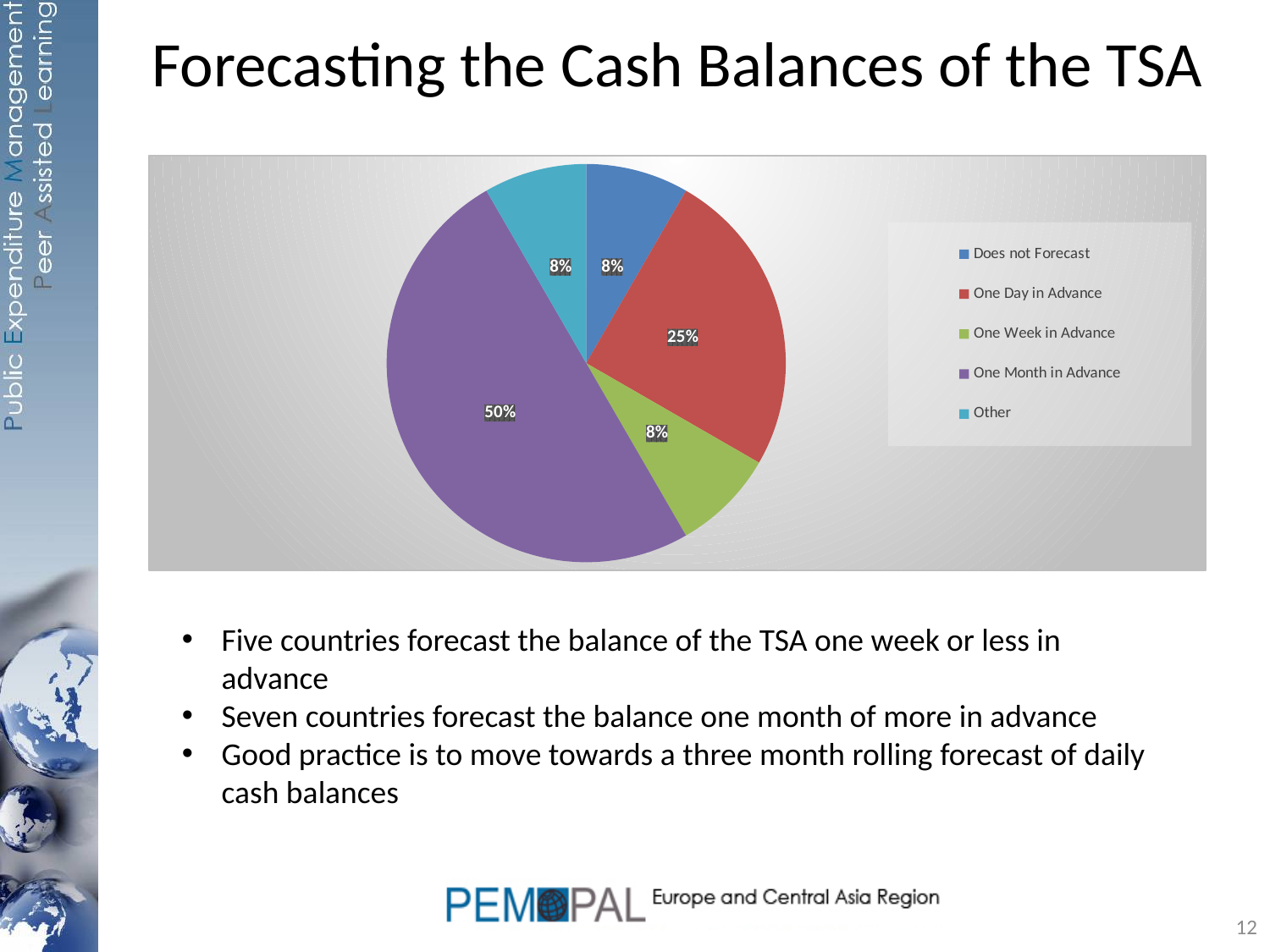
What is the value shown for Other? 8% What share of the pie does One Month in Advance represent? 50% What share of the pie does One Day in Advance represent? 25% What kind of chart is shown on the slide? pie chart What is the value shown for One Week in Advance? 8% Which is larger, the share for One Day in Advance or the share for One Week in Advance? One Day in Advance How many entries does the legend list? 5 How many categories does the pie chart have? 5 What is the value shown for Does not Forecast? 8% Which colour is used for the One Month in Advance slice? purple Which category has the largest slice of the pie? One Month in Advance What is the difference between the One Month in Advance and One Day in Advance shares? 25%